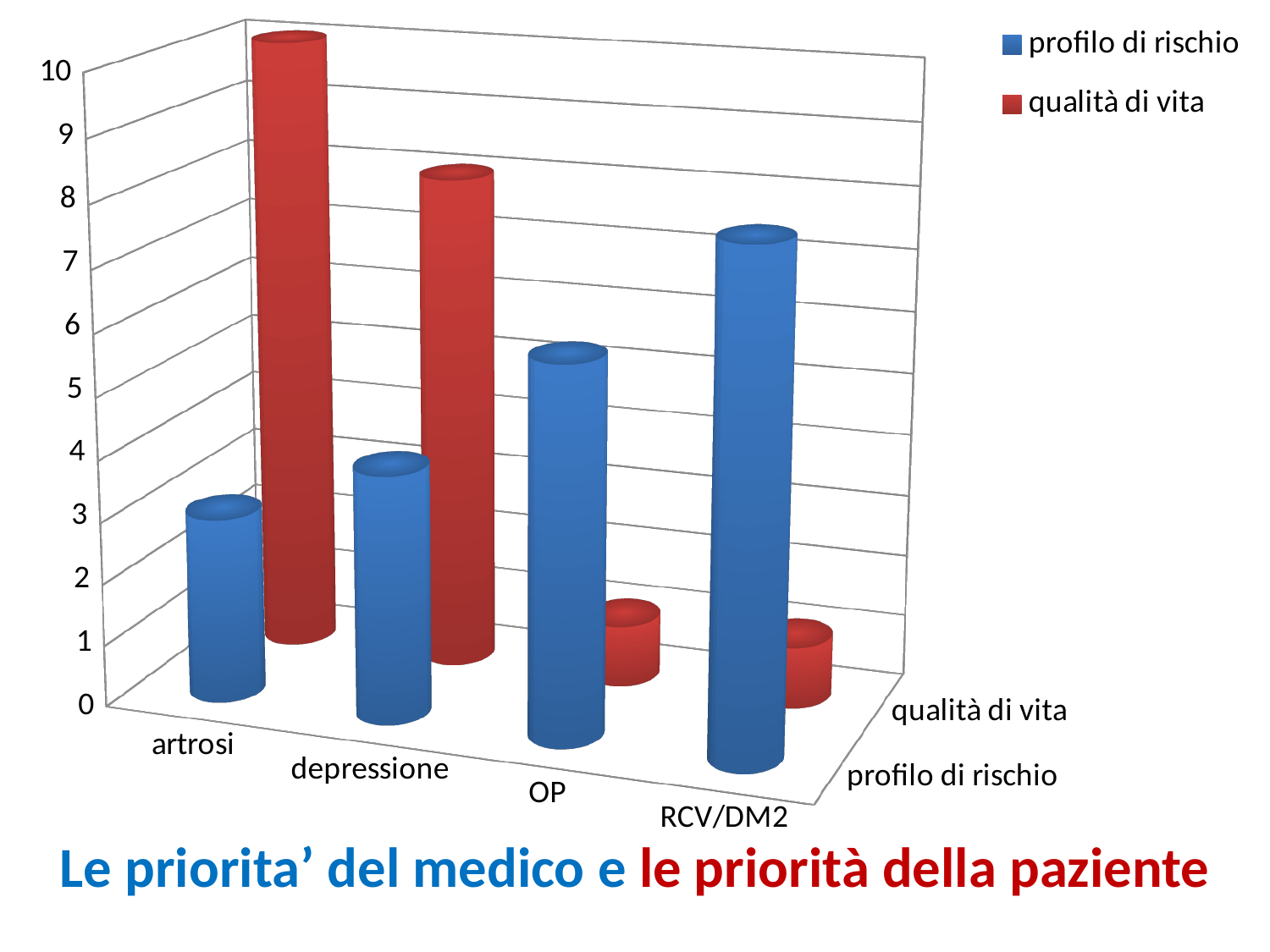
For 'RCV/DM2', which series has the larger value, 'profilo di rischio' or 'qualità di vita'? profilo di rischio Which category has the lowest value for the 'profilo di rischio' series? artrosi Do the 'profilo di rischio' values rise or fall from 'artrosi' to 'RCV/DM2' along the x axis? rise What kind of chart is shown on the slide? bar chart Which category has the highest value for the 'qualità di vita' series? artrosi Which colour represents the 'qualità di vita' series? red For 'artrosi', which series has the larger value, 'profilo di rischio' or 'qualità di vita'? qualità di vita How many categories are shown on the x axis? 4 How many series does the legend list? 2 Which category has the highest value for the 'profilo di rischio' series? RCV/DM2 Is the 'qualità di vita' value for 'OP' greater or less than 5? less Is the 'profilo di rischio' value for 'RCV/DM2' greater or less than 5? greater